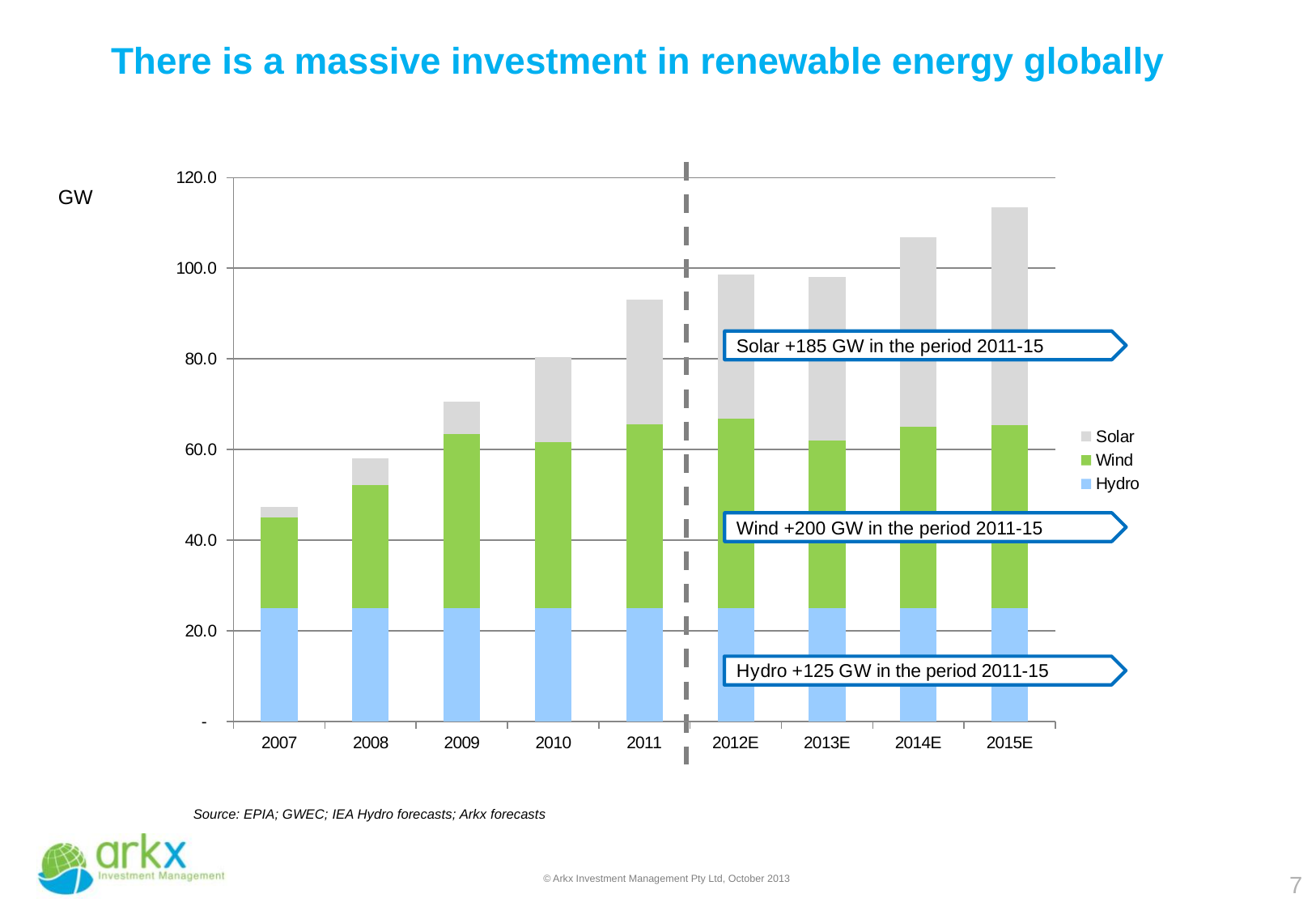
Which year has the larger total, 2010 or 2011? 2011 What kind of chart is shown on the slide? Stacked bar chart Which year has the tallest stacked bar? 2015E Is the total for 2015E greater or less than 100? greater How many series does the legend list? 3 Do the total bar heights generally rise or fall from 2007 to 2015E? rise Is the total for 2007 greater or less than 60? less How many years (categories) are shown on the x axis? 9 Is the total for 2011 greater or less than 80? greater According to the annotation on the chart, how much is Solar expected to add in the period 2011-15? +185 GW Which year has the shortest stacked bar? 2007